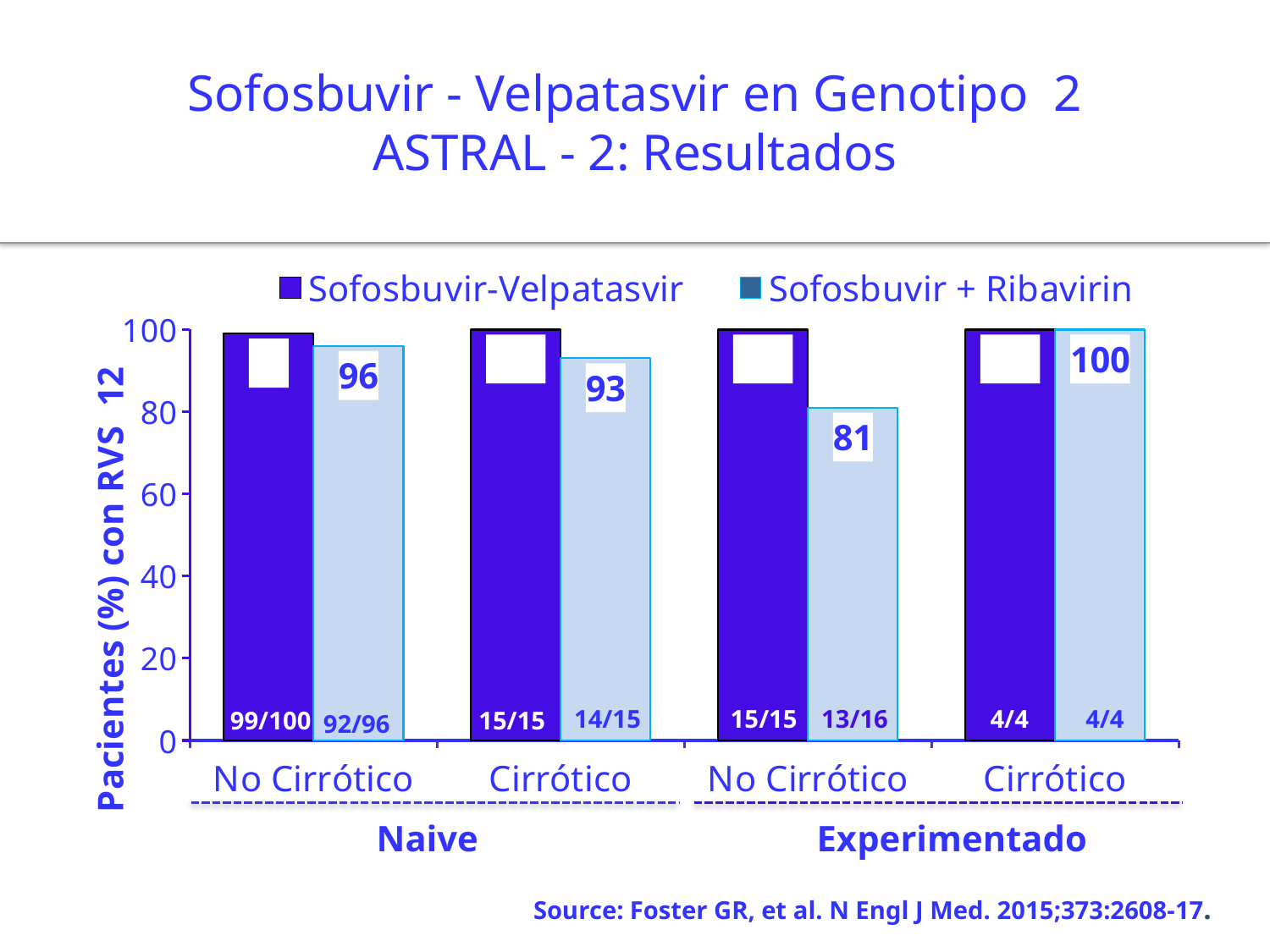
Which group has the lowest value for Sofosbuvir + Ribavirin? Experimentado No Cirrótico How many patient groups are shown on the x axis? 4 What is the value for Sofosbuvir + Ribavirin in the Naive No Cirrótico group? 96 What is the value for Sofosbuvir + Ribavirin in the Naive Cirrótico group? 93 What kind of chart is shown on the slide? bar chart In the Experimentado No Cirrótico group, which series has the larger value, Sofosbuvir-Velpatasvir or Sofosbuvir + Ribavirin? Sofosbuvir-Velpatasvir What is the difference between the Sofosbuvir + Ribavirin values for Naive No Cirrótico and Experimentado No Cirrótico? 15 What is the value for Sofosbuvir + Ribavirin in the Experimentado No Cirrótico group? 81 What is the value for Sofosbuvir + Ribavirin in the Experimentado Cirrótico group? 100 What is the label of the y axis? Pacientes (%) con RVS 12 Is the value for Sofosbuvir-Velpatasvir in the Experimentado No Cirrótico group greater or less than 80? greater How many series does the legend list? 2